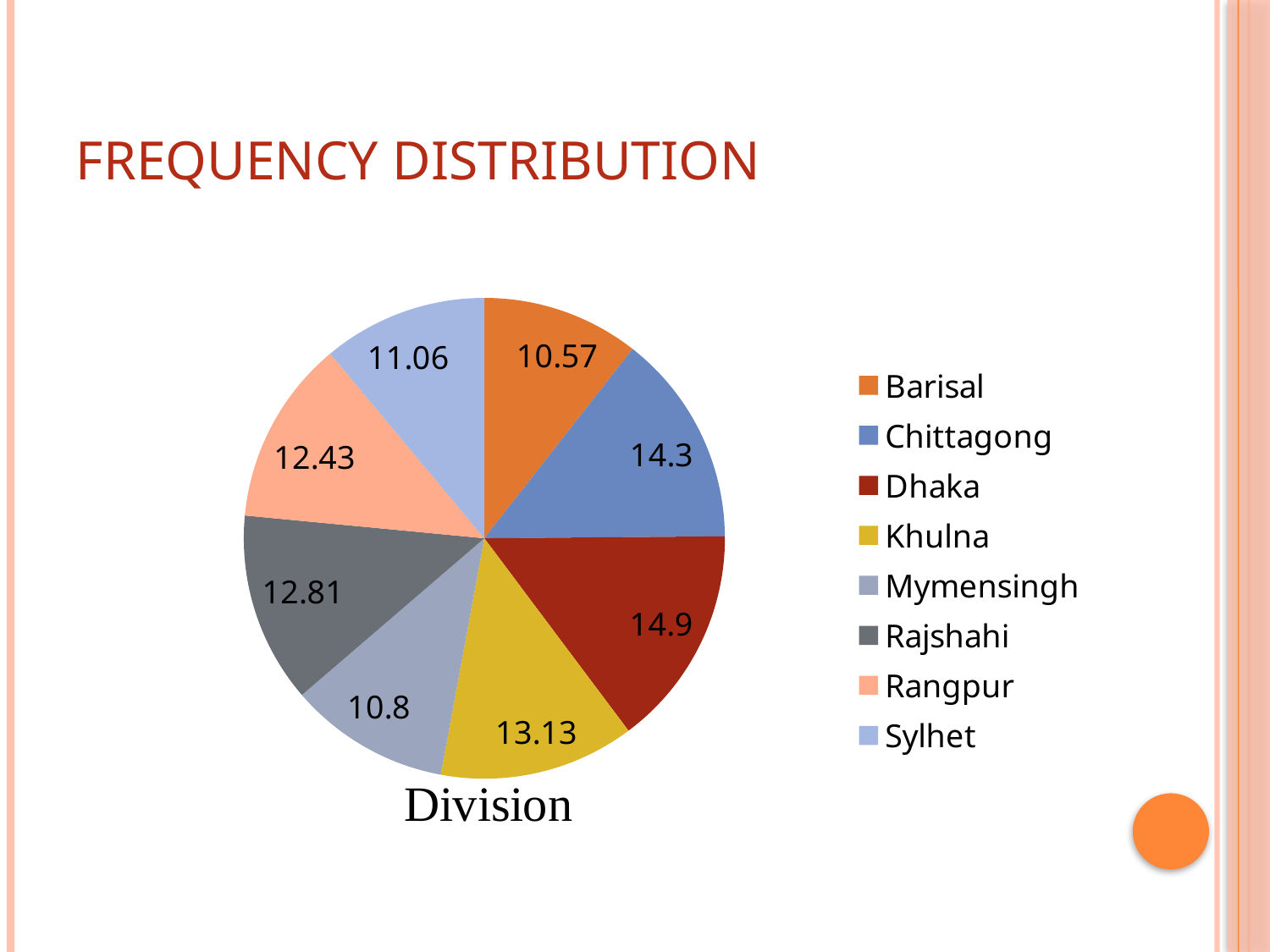
What is the difference between the values for Dhaka and Chittagong? 0.6 Which division has the largest slice in the pie chart? Dhaka What is the value shown for Sylhet in the pie chart? 11.06 What is the value shown for Rangpur in the pie chart? 12.43 What is the value shown for Dhaka in the pie chart? 14.9 Which division has the smallest slice in the pie chart? Barisal What is the value shown for Barisal in the pie chart? 10.57 What is the title printed below the pie chart? Division What type of chart is shown on the slide? Pie chart Which is larger, the value for Rajshahi or the value for Rangpur? Rajshahi How many divisions are shown in the pie chart? 8 What is the difference between the values for Khulna and Mymensingh? 2.33